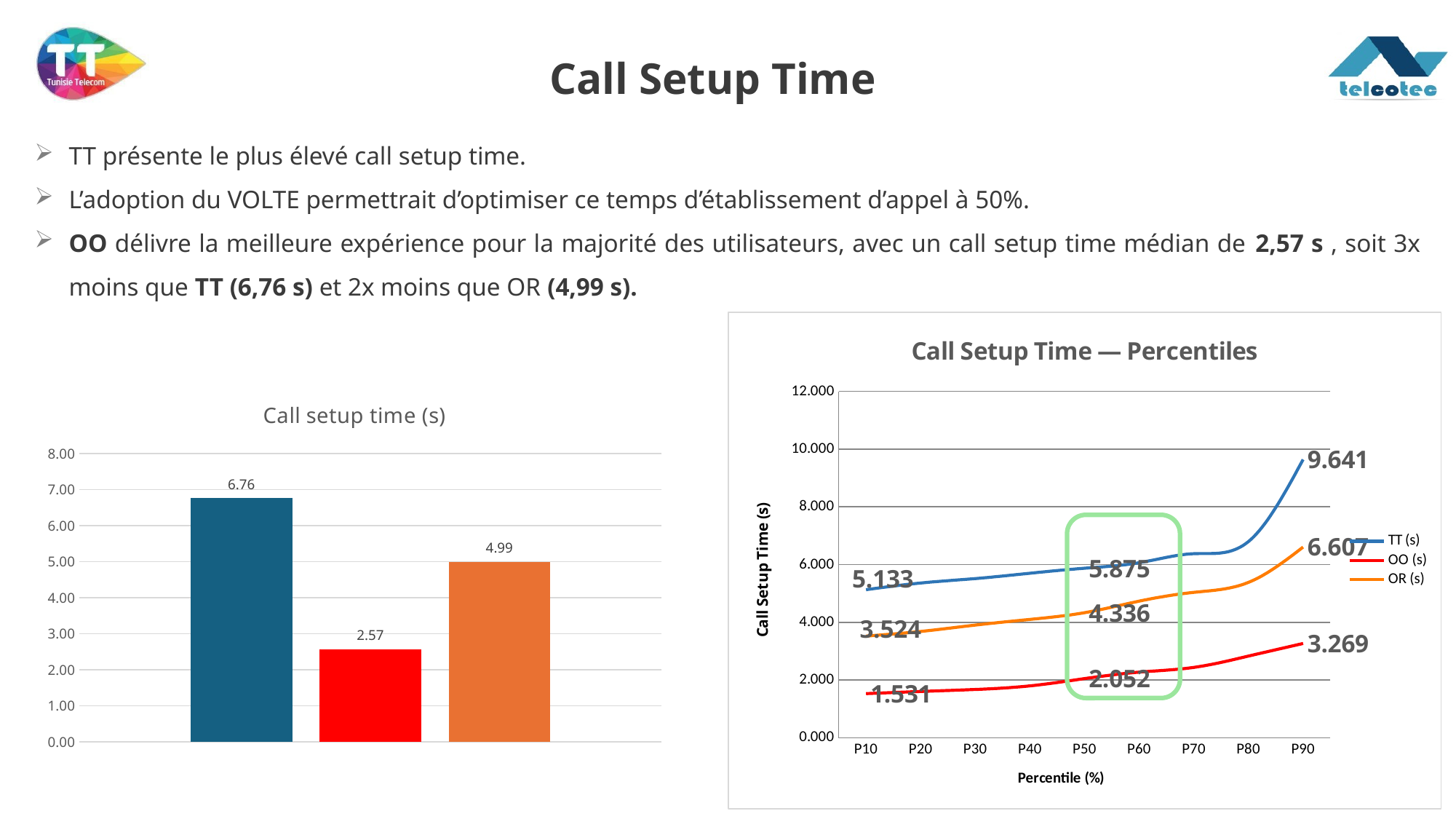
What kind of chart is the chart titled 'Call Setup Time — Percentiles'? Line chart In the bar chart titled 'Call setup time (s)', what is the value of the orange (right) bar? 4.99 In the chart 'Call Setup Time — Percentiles', which series has the highest value at P90? TT (s) How many bars are shown in the bar chart titled 'Call setup time (s)'? 3 In the chart 'Call Setup Time — Percentiles', is the value of TT (s) at P80 greater or less than 6.000? greater In the bar chart titled 'Call setup time (s)', what is the value of the tallest bar? 6.76 In the chart 'Call Setup Time — Percentiles', what is the value of OR (s) at P10? 3.524 How many series does the legend of the chart 'Call Setup Time — Percentiles' list? 3 In the bar chart titled 'Call setup time (s)', what is the value of the red (middle) bar? 2.57 In the chart 'Call Setup Time — Percentiles', what is the value of OO (s) at P50? 2.052 In the chart 'Call Setup Time — Percentiles', what is the value of TT (s) at P90? 9.641 In the bar chart titled 'Call setup time (s)', what is the difference between the tallest and the shortest bar? 4.19